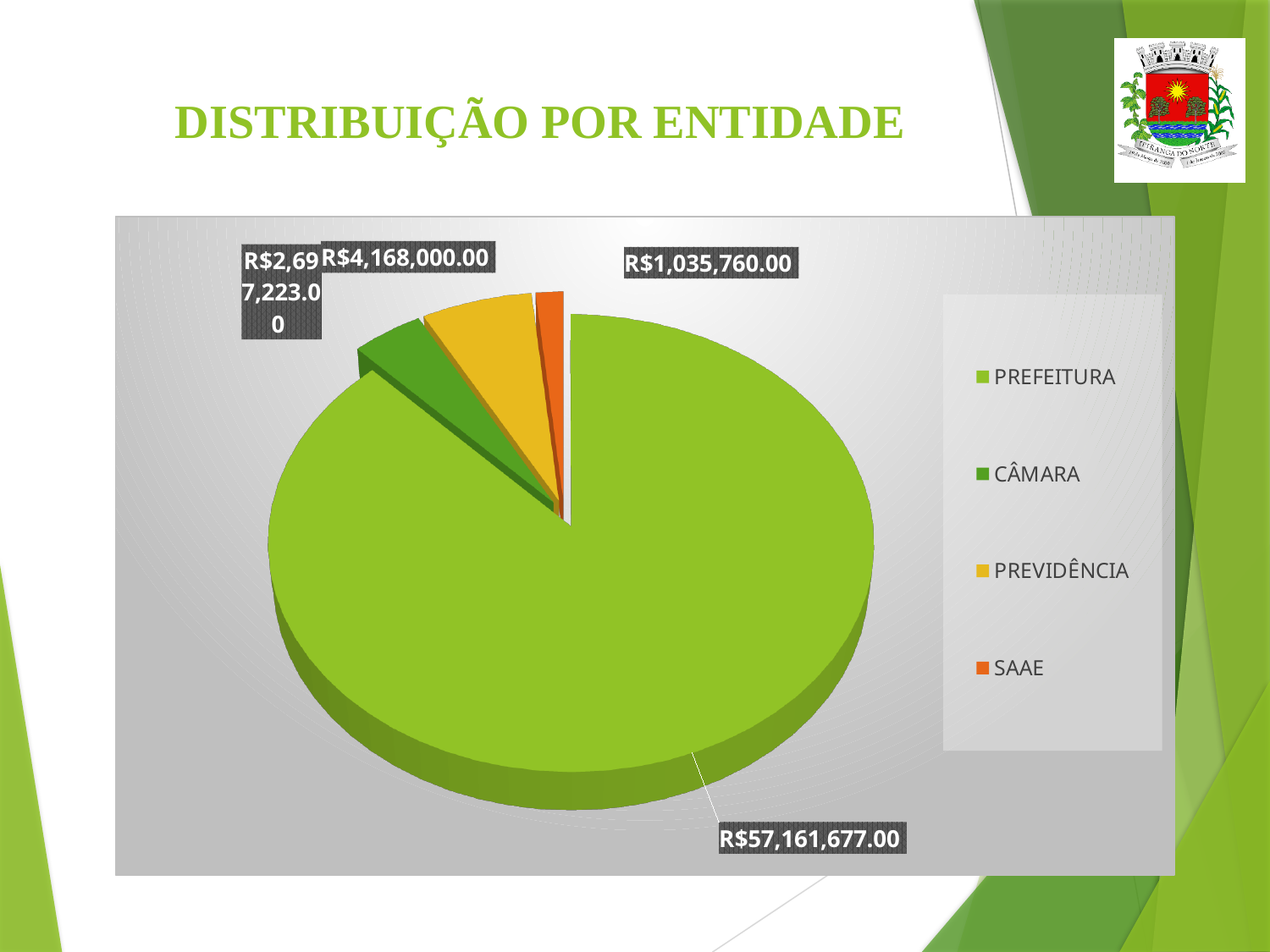
What is the value for SAAE? R$1,035,760.00 What is the value for PREFEITURA? R$57,161,677.00 What is the title of the chart? DISTRIBUIÇÃO POR ENTIDADE Which entity has the largest slice of the pie? PREFEITURA What type of chart is shown on the slide? Pie chart Which colour represents SAAE in the chart? Orange Which is larger, the value for PREVIDÊNCIA or the value for CÂMARA? PREVIDÊNCIA What is the value for PREVIDÊNCIA? R$4,168,000.00 What is the difference between the values for PREVIDÊNCIA and SAAE? R$3,132,240.00 What is the value for CÂMARA? R$2,697,223.00 How many entities does the legend list? 4 Which entity has the smallest slice of the pie? SAAE